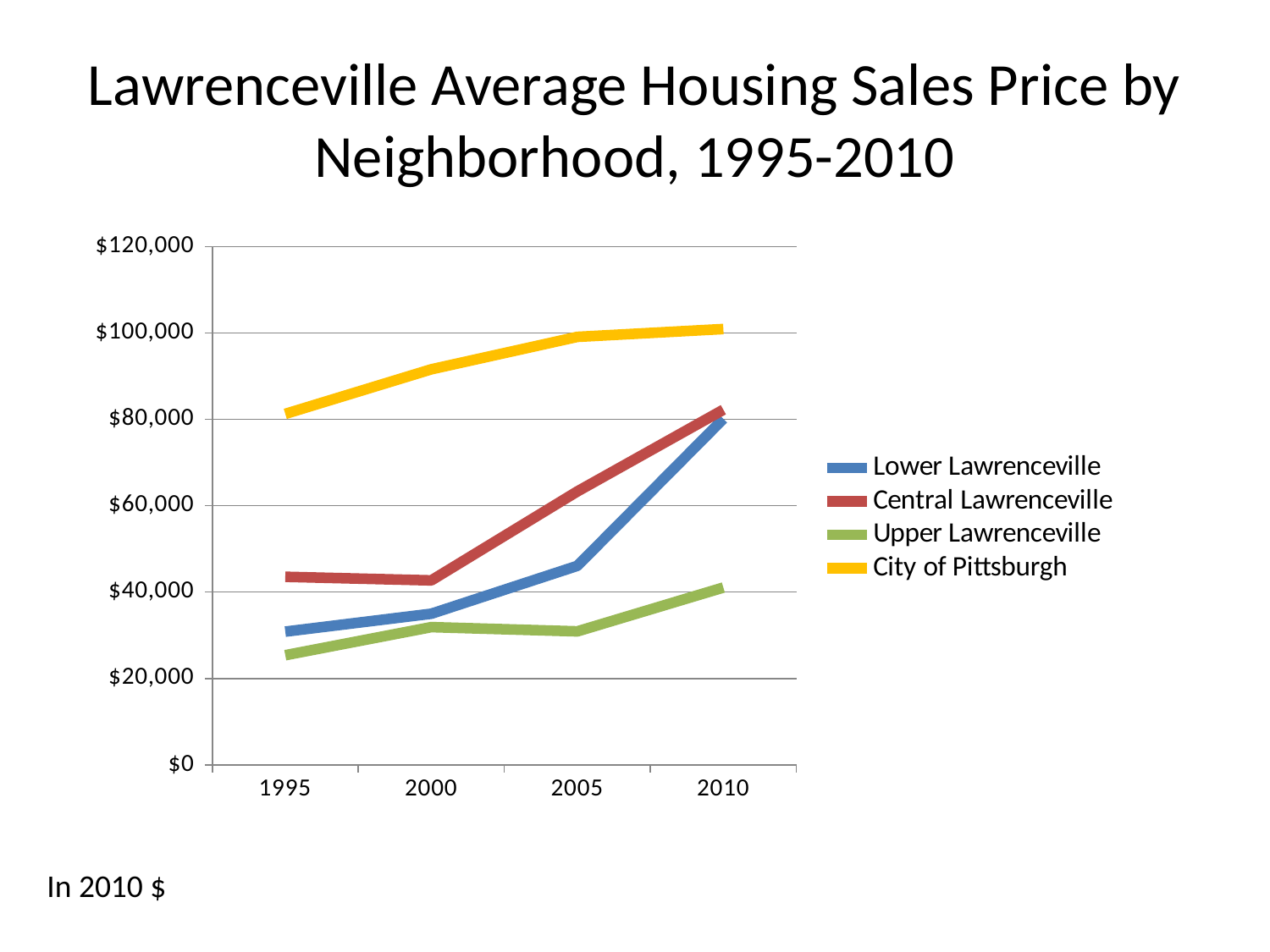
Is the value for Lower Lawrenceville in 2005 greater or less than $40,000? greater In 2005, which is larger: the value for Central Lawrenceville or the value for Lower Lawrenceville? Central Lawrenceville How many series does the legend list? 4 Is the value for Upper Lawrenceville in 1995 greater or less than $20,000? greater Which series has the lowest value in 2010? Upper Lawrenceville What kind of chart is shown on the slide? line chart How many years are plotted along the x axis? 4 Is the value for City of Pittsburgh in 2000 greater or less than $100,000? less Which series has the highest value in 2010? City of Pittsburgh Does the City of Pittsburgh line rise or fall from 1995 to 2010? rise Which series is drawn in yellow? City of Pittsburgh